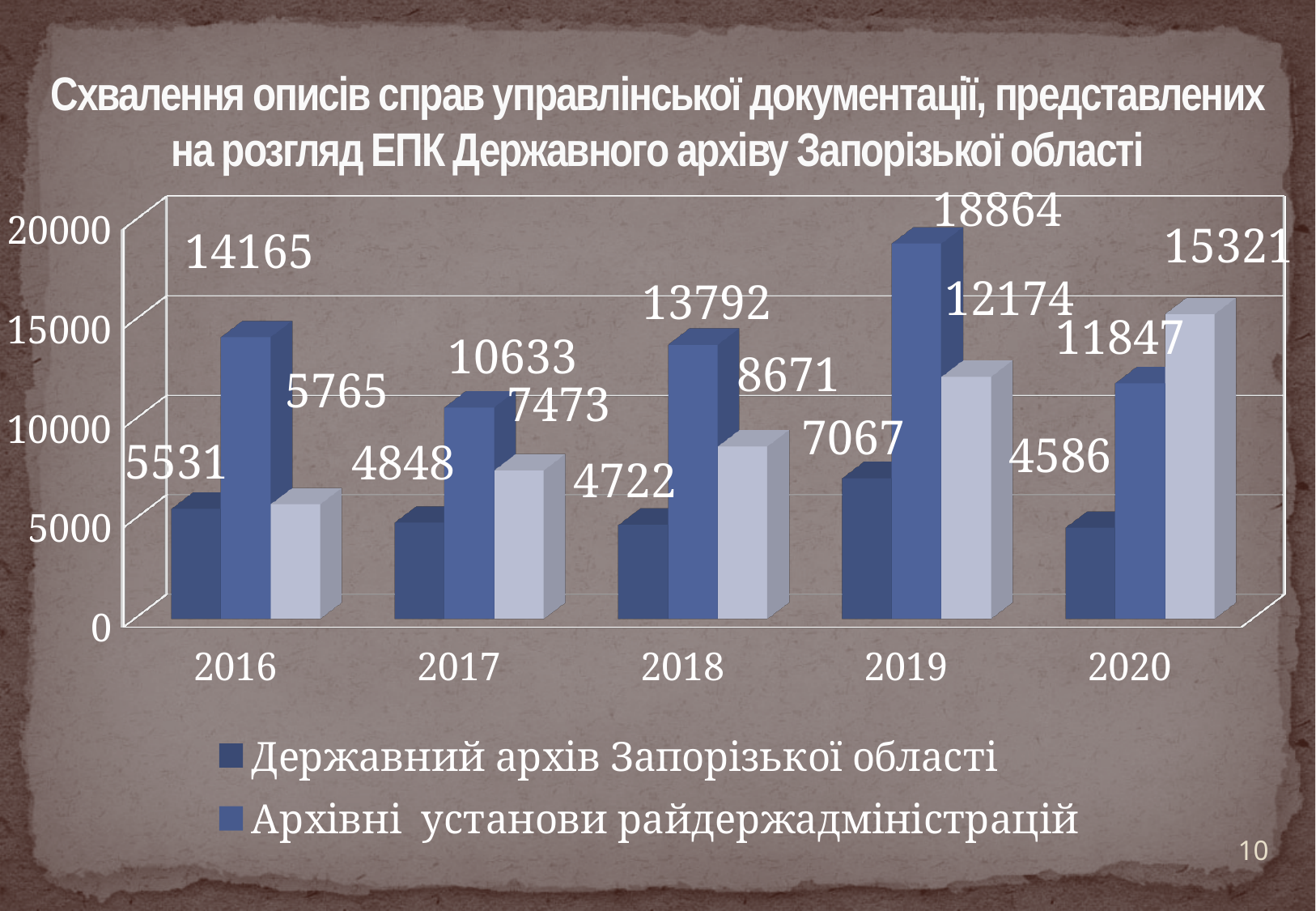
What kind of chart is shown on the slide? bar chart How many series does the legend list? 2 How many years are shown on the x axis? 5 In which year is the value for Державний архів Запорізької області the lowest? 2020 Is the value for Архівні установи райдержадміністрацій in 2020 greater or less than 10000? greater What is the difference between Архівні установи райдержадміністрацій and Державний архів Запорізької області in 2016? 8634 What is the value for Державний архів Запорізької області in 2019? 7067 Does the value for Державний архів Запорізької області rise or fall from 2016 to 2018? fall In which year is the value for Архівні установи райдержадміністрацій the highest? 2019 What is the value for Державний архів Запорізької області in 2017? 4848 What is the value for Архівні установи райдержадміністрацій in 2018? 13792 Which is larger: the value for Державний архів Запорізької області in 2016 or in 2017? 2016